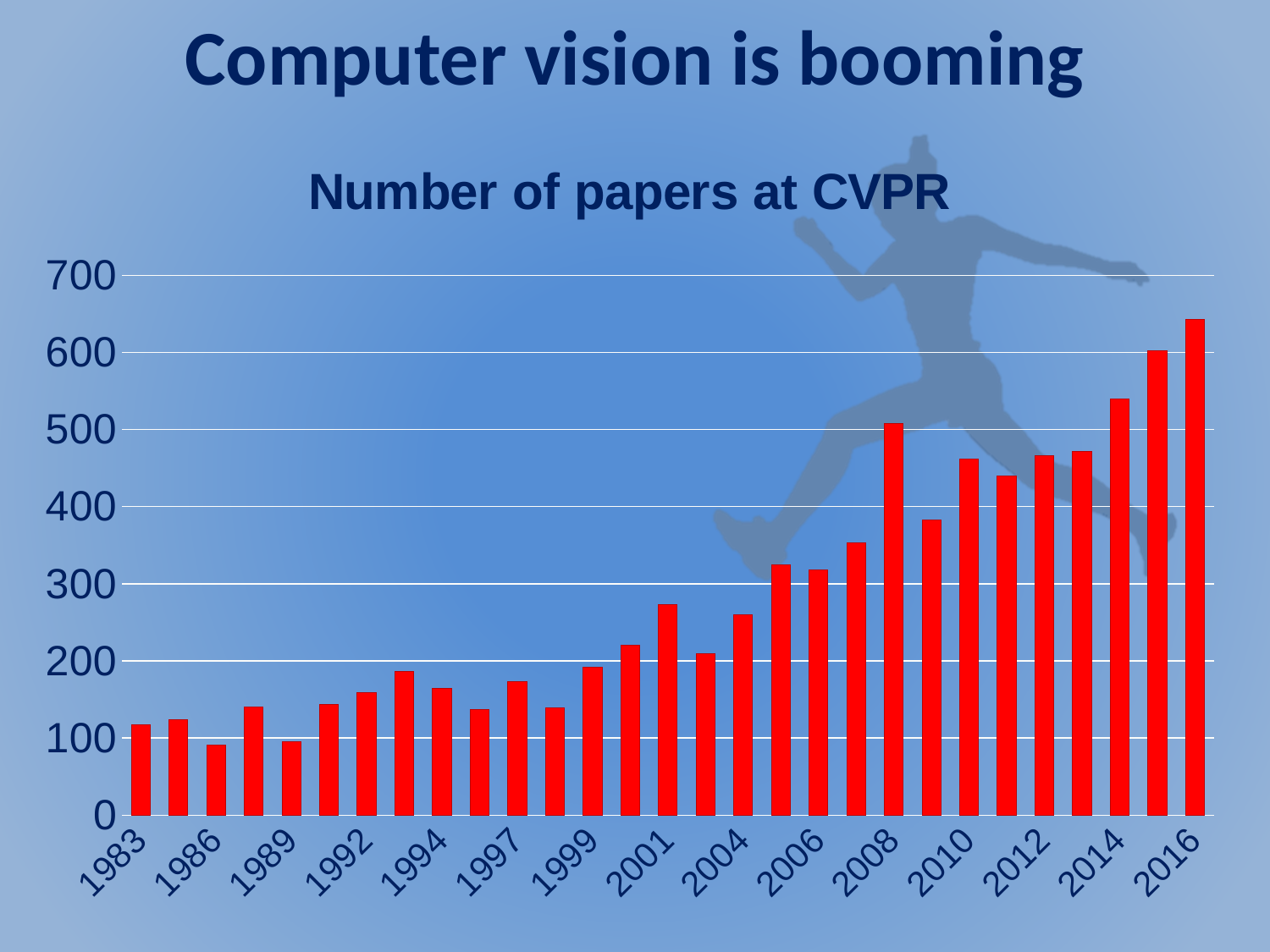
Is the value for 1992 greater or less than 200? less Which year has the highest number of papers at CVPR? 2016 Is the value for 1986 greater or less than 100? less Is the value for 2016 greater or less than 600? greater What colour are the bars in the chart? red What is the title of the chart? Number of papers at CVPR What kind of chart is shown on the slide? bar chart Overall, do the number of papers rise or fall from 1983 to 2016? rise Which year has more papers, 2008 or 2010? 2008 Which year has more papers, 2012 or 2014? 2014